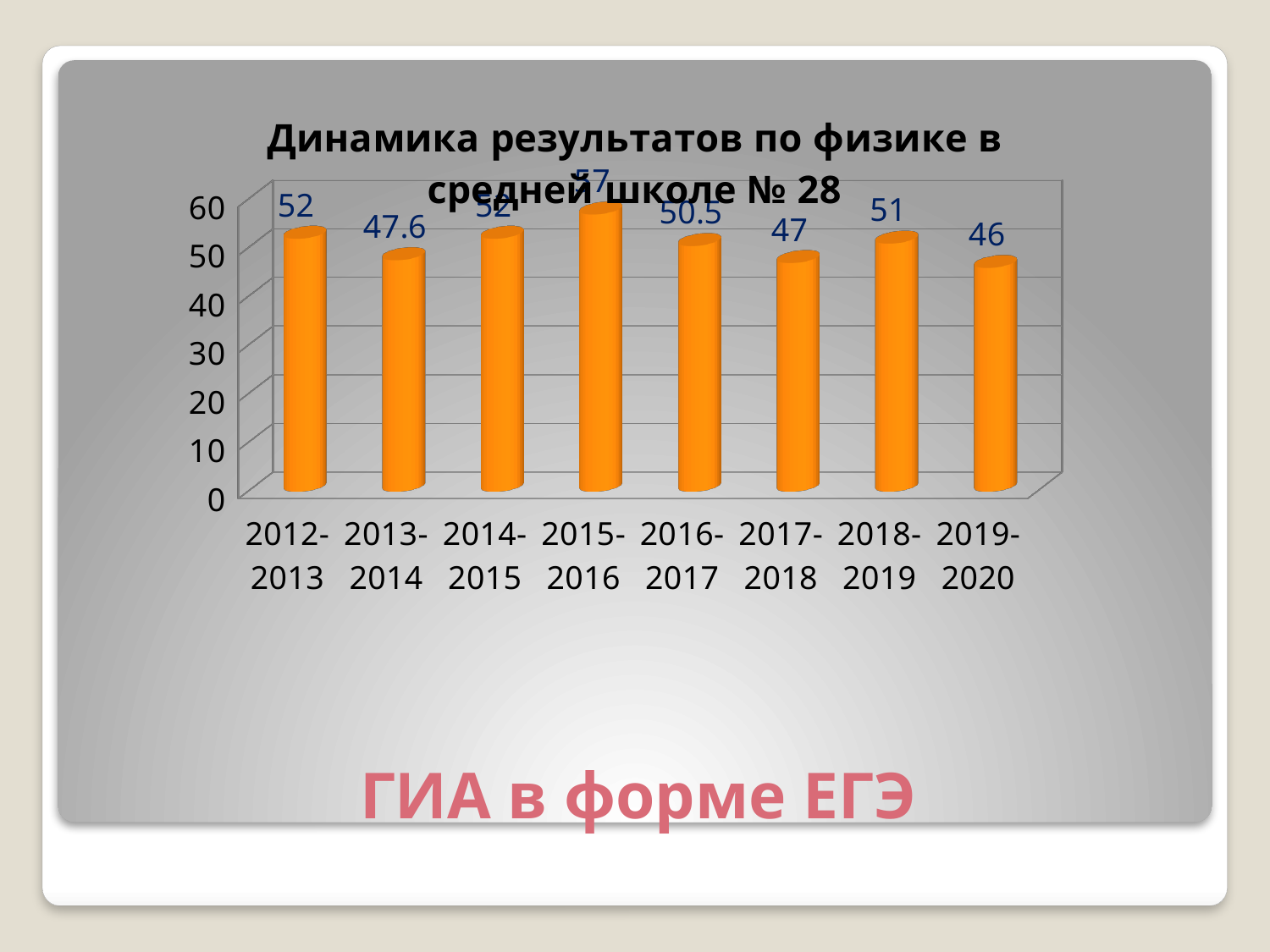
Which school year has the lowest value? 2019-2020 What type of chart is shown on the slide? bar chart Is the value for 2017-2018 greater or less than 50? less Which school year has the highest value? 2015-2016 How many school years (categories) are shown on the x axis? 8 Which is larger, the value for 2018-2019 or the value for 2019-2020? 2018-2019 What is the difference between the values for 2012-2013 and 2013-2014? 4.4 What is the value for 2012-2013? 52 What is the value for 2016-2017? 50.5 What is the title of the chart? Динамика результатов по физике в средней школе № 28 What is the value for 2013-2014? 47.6 What is the value for 2019-2020? 46